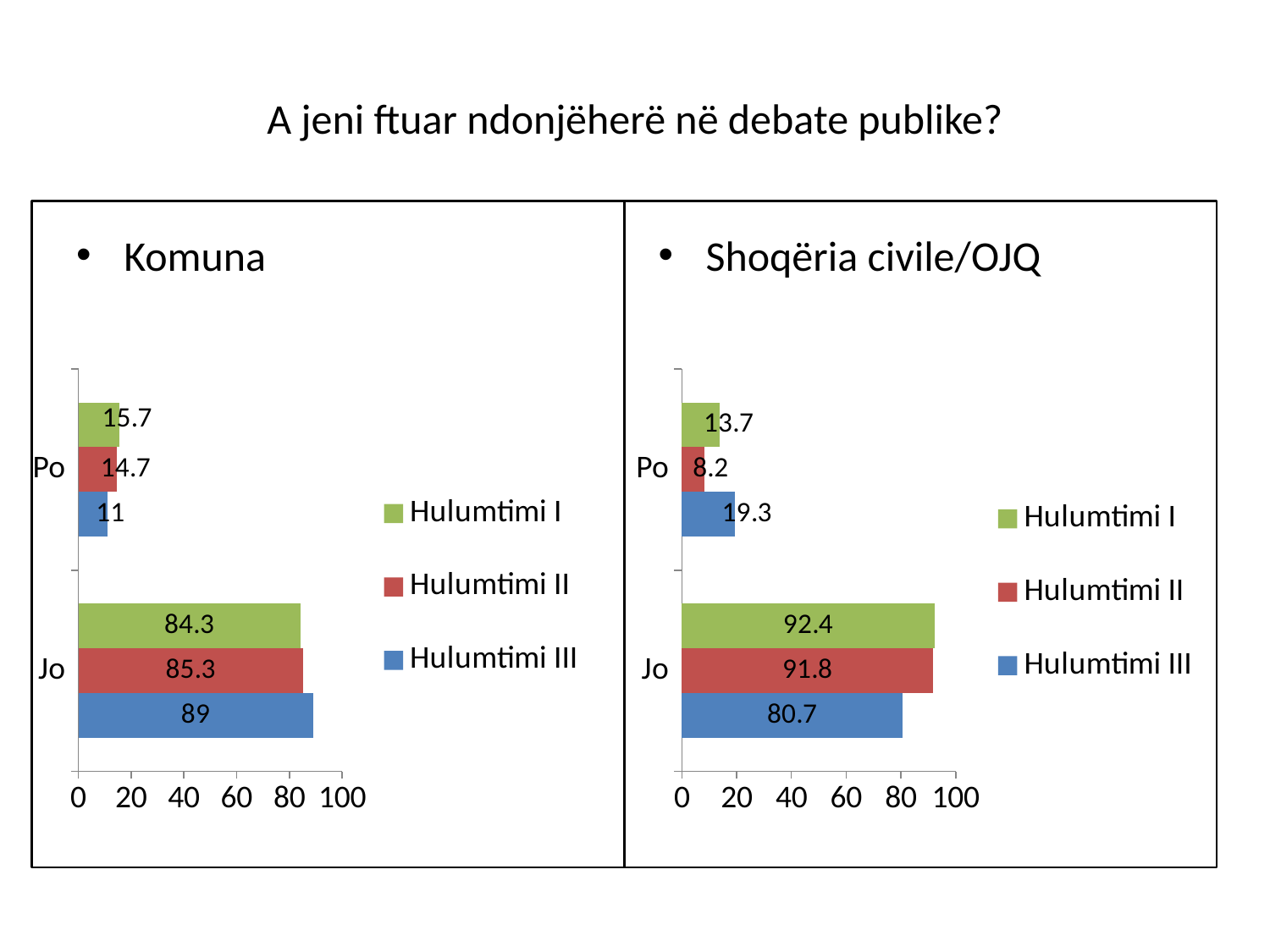
In the Komuna chart, what is the difference between the Jo and Po values for Hulumtimi III? 78 In the Shoqëria civile/OJQ chart, which is larger for Hulumtimi III: the Po value or the Jo value? Jo In the Komuna chart, which series has the lowest value in the Po category? Hulumtimi III What kind of chart is the Shoqëria civile/OJQ chart? Bar chart In the Shoqëria civile/OJQ chart, which series has the highest value in the Po category? Hulumtimi III In the Shoqëria civile/OJQ chart, what is the value for Hulumtimi II in the Po category? 8.2 In the Shoqëria civile/OJQ chart, what is the value for Hulumtimi I in the Jo category? 92.4 In the Komuna chart, what is the value for Hulumtimi I in the Po category? 15.7 In the Shoqëria civile/OJQ chart, what is the difference between Hulumtimi I and Hulumtimi III in the Jo category? 11.7 In the Komuna chart, which colour represents Hulumtimi II? Red How many series does the legend of the Komuna chart list? 3 In the Komuna chart, what is the value for Hulumtimi III in the Jo category? 89